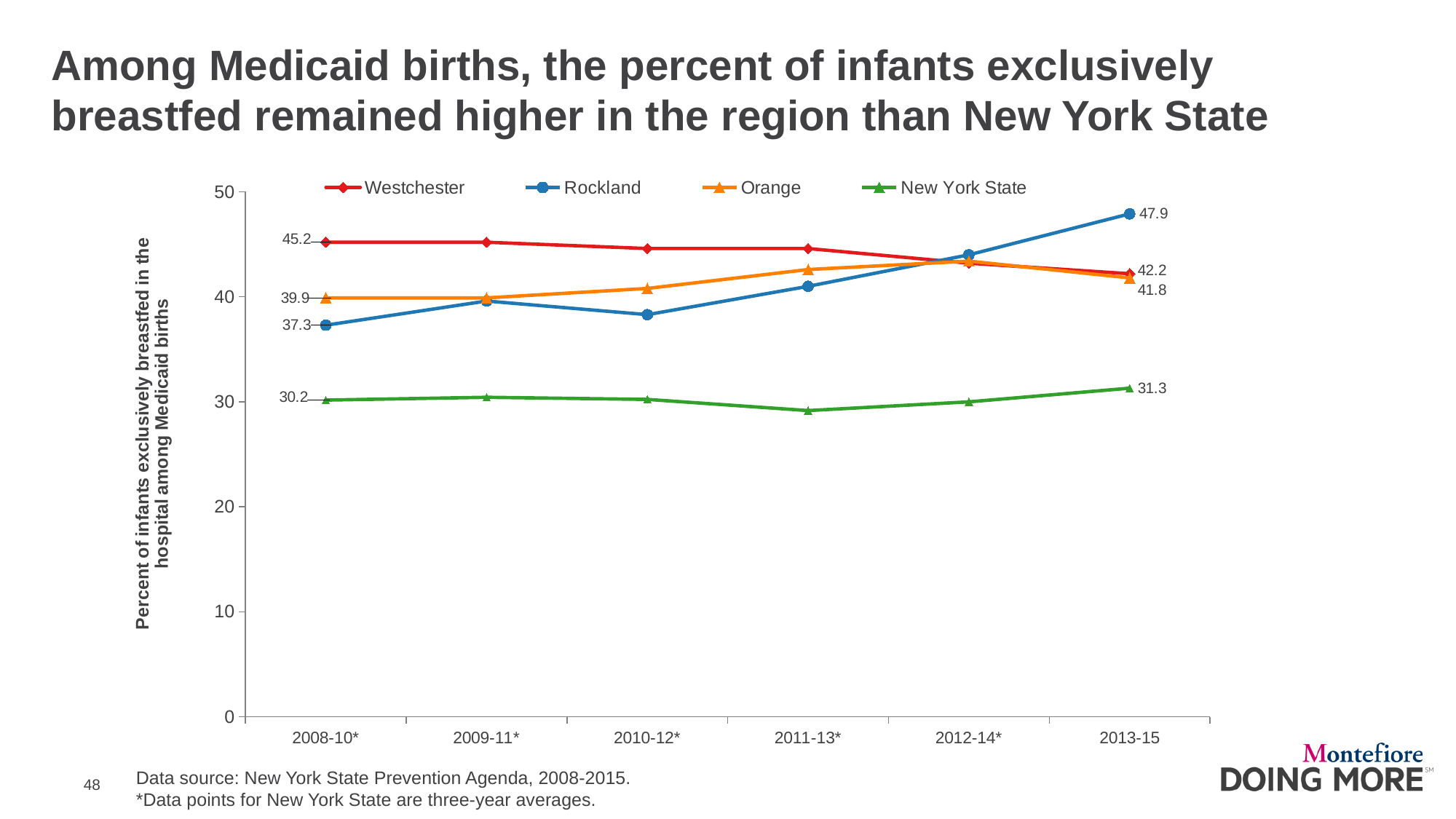
What value does the Rockland line reach in 2013-15? 47.9 Is the Westchester value for 2011-13* greater or less than 40? greater What was the New York State value in 2008-10*? 30.2 What was the percent of infants exclusively breastfed among Medicaid births in Westchester in 2008-10*? 45.2 By how much did the Rockland value increase from 2008-10* to 2013-15? 10.6 What was the Orange value in 2013-15? 41.8 How many time periods are shown on the x axis? 6 Which series had the lowest value in 2008-10*? New York State Did the Rockland line rise or fall from 2008-10* to 2013-15? rise How many series does the legend list? 4 Which series had the highest value in 2013-15? Rockland In 2013-15, which was higher, Westchester or Orange? Westchester